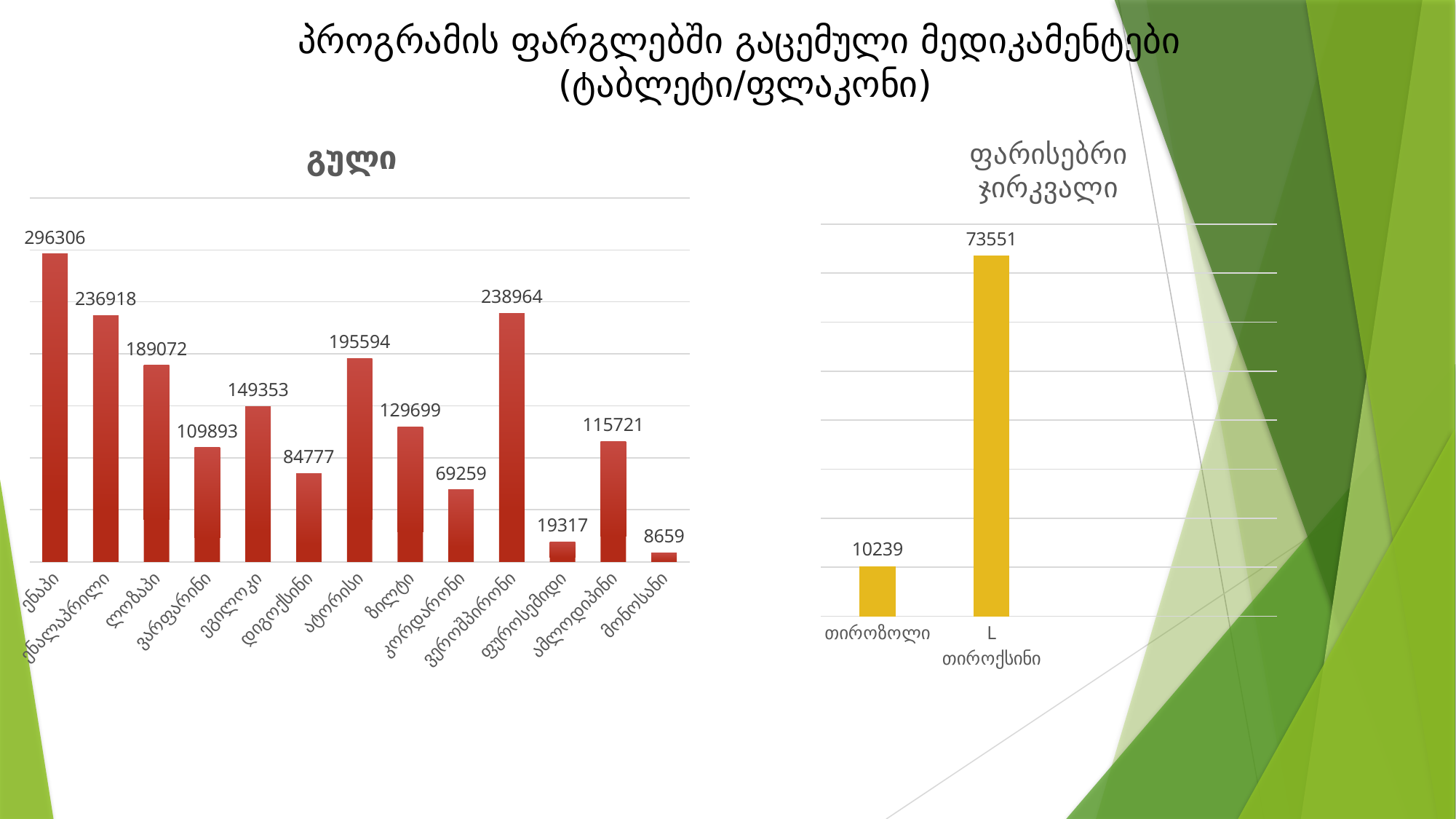
In the "ფარისებრი ჯირკვალი" chart, what is the value for L თიროქსინი? 73551 What colour are the bars in the "ფარისებრი ჯირკვალი" chart? yellow In the "გული" chart, what is the value for ვეროშპირონი? 238964 What type of chart is the "გული" chart? bar chart How many categories are shown in the "გული" chart? 13 In the "გული" chart, what is the difference between the values for ენაპი and ენალაპრილი? 59388 In the "გული" chart, what is the value for ენაპი? 296306 In the "გული" chart, which is larger: the value for ატორისი or the value for ლოზაპი? ატორისი In the "ფარისებრი ჯირკვალი" chart, what is the value for თიროზოლი? 10239 In the "ფარისებრი ჯირკვალი" chart, what is the difference between the values for L თიროქსინი and თიროზოლი? 63312 In the "გული" chart, which category has the highest value? ენაპი In the "გული" chart, which category has the lowest value? მონოსანი